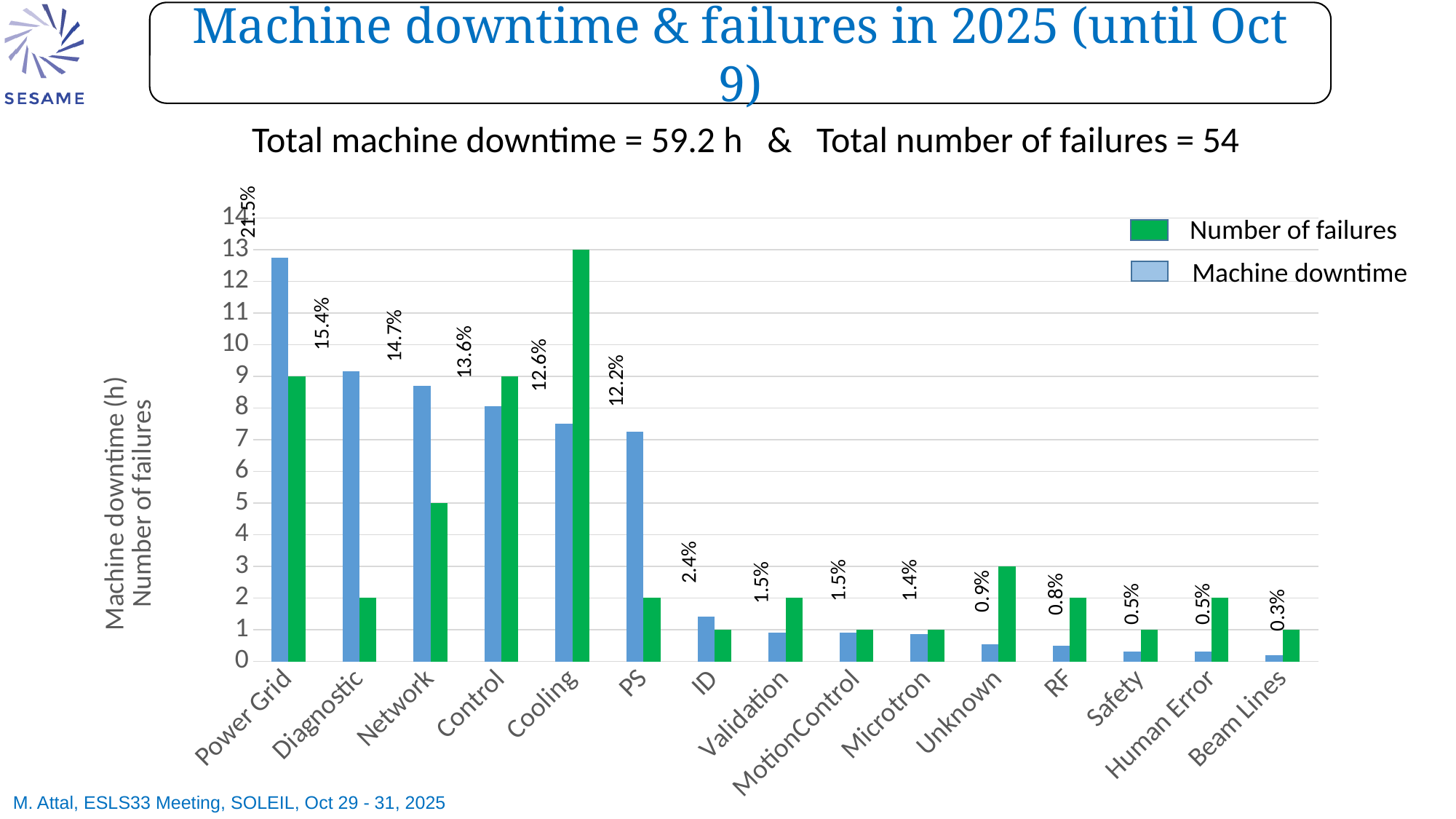
Which category has the lowest percentage label? Beam Lines How many categories are shown on the x axis? 15 What is the number of failures for Network? 5 What is the difference between the number of failures for Cooling and for Power Grid? 4 Which category has the highest number of failures? Cooling What colour represents Number of failures in the legend? green Is the machine downtime for Power Grid greater or less than 12? greater What percentage label is shown for Power Grid? 21.5% What kind of chart is shown on the slide? bar chart What is the number of failures for Cooling? 13 Which has more failures, Network or Diagnostic? Network How many series does the legend list? 2